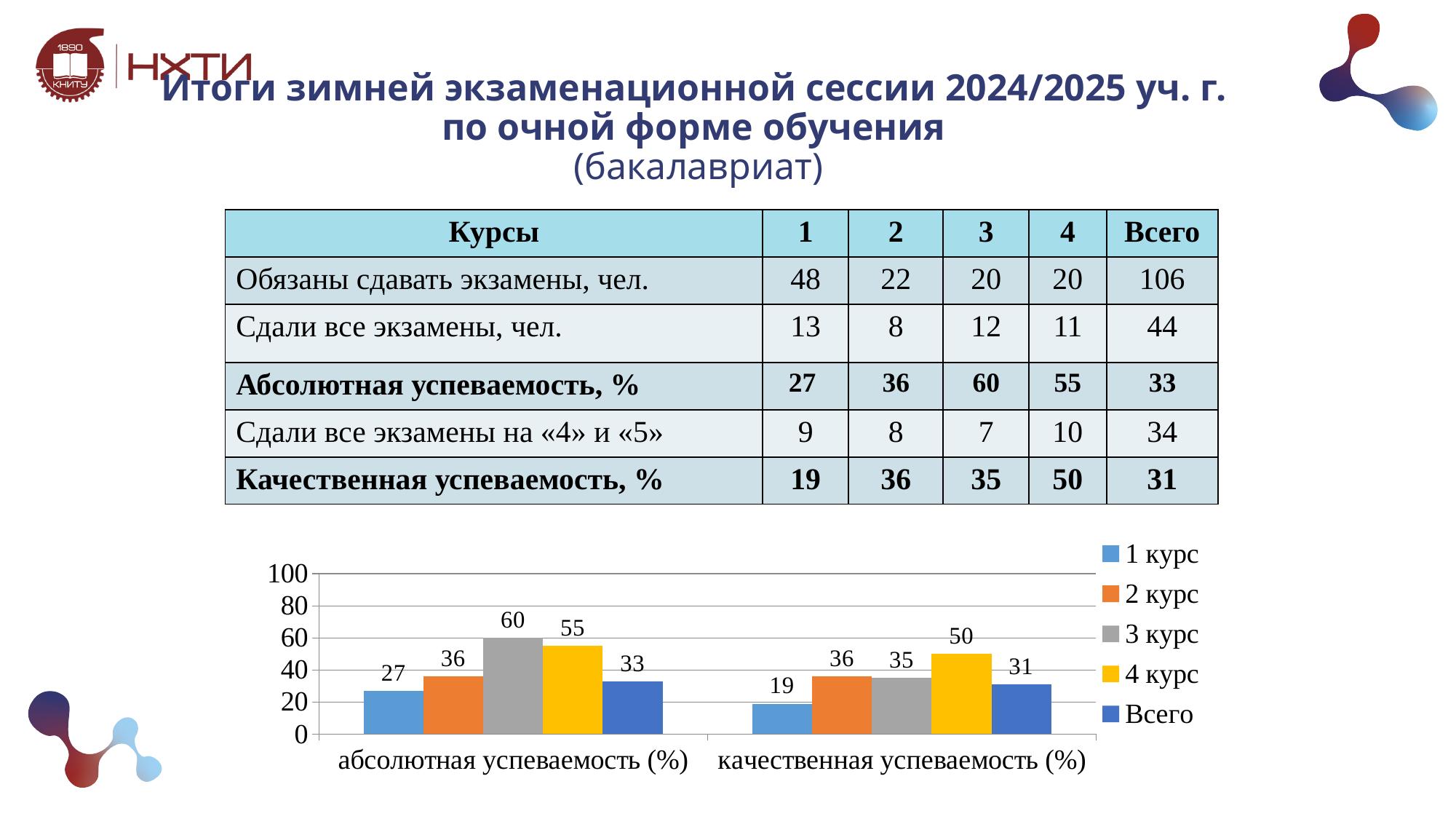
Which series has the highest value in the абсолютная успеваемость (%) category? 3 курс What type of chart is shown on the slide? bar chart Is the value for 3 курс in the абсолютная успеваемость (%) category greater or less than 40? greater What is the value for 3 курс in the абсолютная успеваемость (%) category? 60 What is the difference between the 4 курс value and the 1 курс value in the качественная успеваемость (%) category? 31 What is the value for 1 курс in the качественная успеваемость (%) category? 19 What colour are the bars for the 4 курс series in the chart? yellow How many categories are shown on the x axis of the chart? 2 How many series does the chart legend list? 5 Which series has the lowest value in the качественная успеваемость (%) category? 1 курс Which is larger in the абсолютная успеваемость (%) category: the value for 2 курс or the value for 4 курс? 4 курс What is the value for Всего in the абсолютная успеваемость (%) category? 33